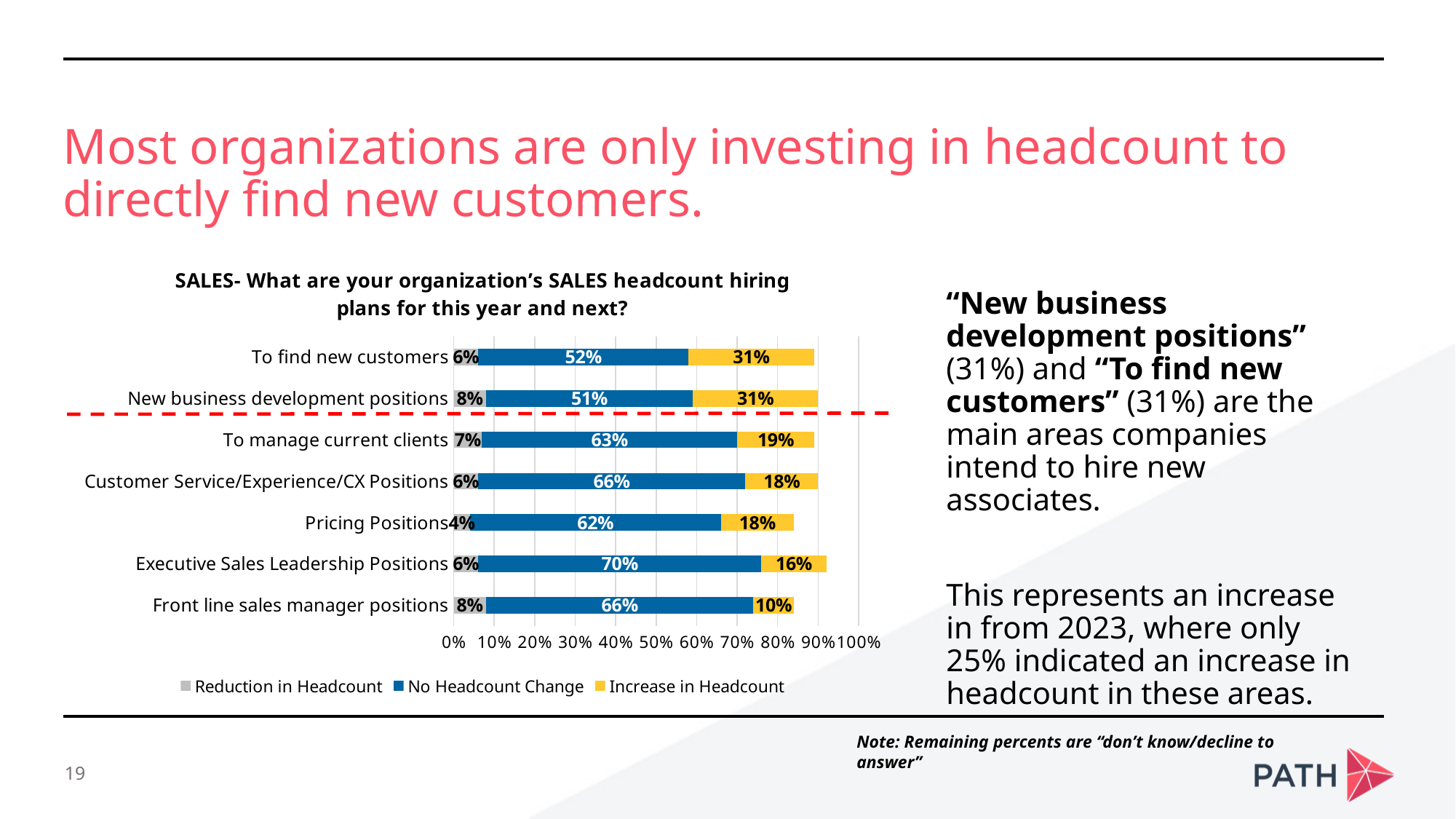
What is the No Headcount Change value for "Pricing Positions"? 62% What kind of chart is shown on the slide? Stacked bar chart What is the Reduction in Headcount value for "Front line sales manager positions"? 8% Which category has the highest No Headcount Change value? Executive Sales Leadership Positions What is the difference between the No Headcount Change values for "Executive Sales Leadership Positions" and "New business development positions"? 19 percentage points How many categories (hiring areas) are plotted in the chart? 7 How many series does the chart legend list? 3 Which series in the legend is shown in yellow? Increase in Headcount Which category has the lowest Increase in Headcount value? Front line sales manager positions What is the Increase in Headcount value for "To manage current clients"? 19% What is the total of the three labelled segments for "Executive Sales Leadership Positions"? 92% Which is larger: the Increase in Headcount value for "To manage current clients" or for "Executive Sales Leadership Positions"? To manage current clients